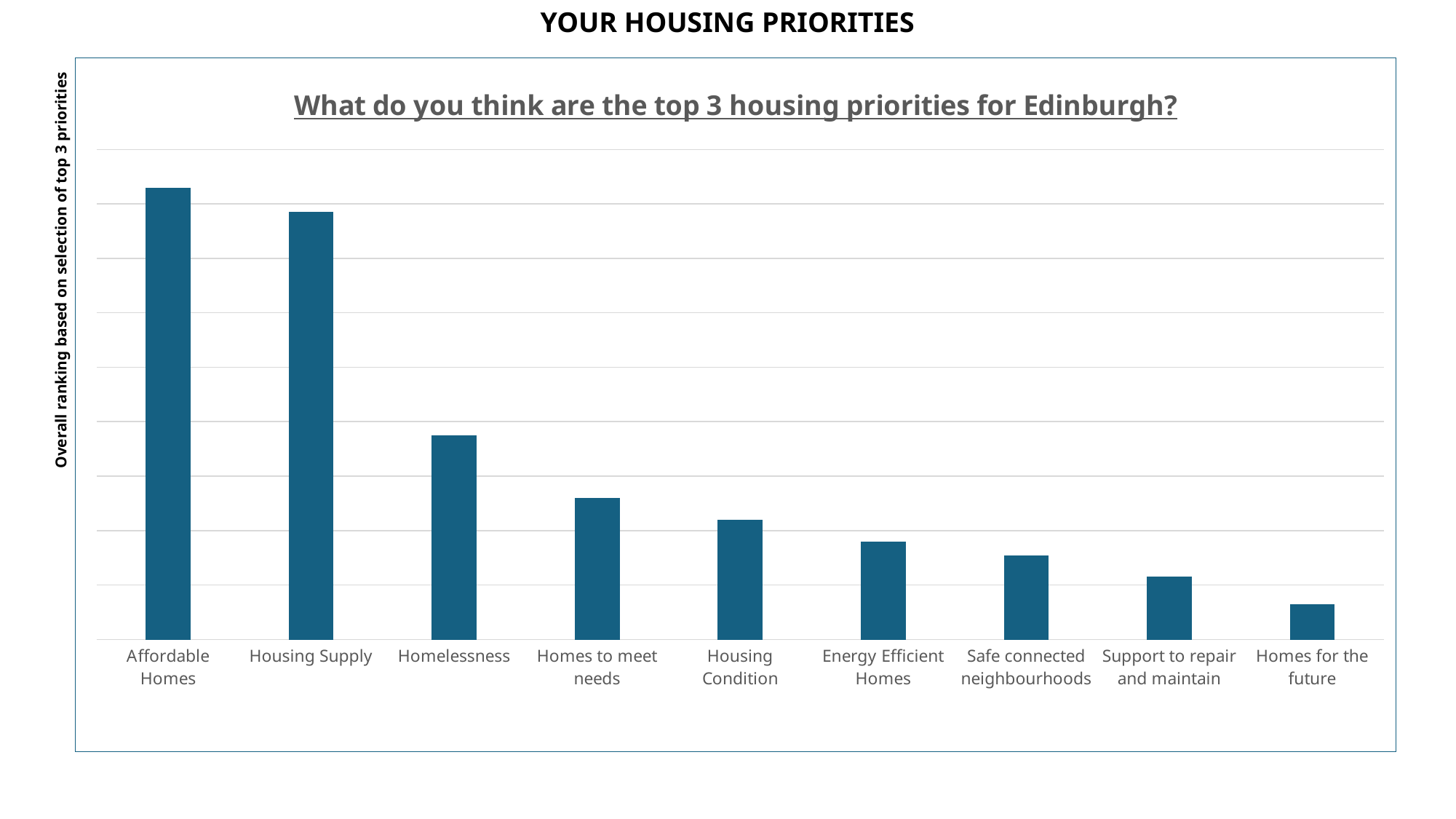
Which category has the highest value in the chart? Affordable Homes What is the title of the chart? What do you think are the top 3 housing priorities for Edinburgh? How many categories are shown on the x axis of the chart? 9 Which is larger, the value for Homelessness or the value for Homes to meet needs? Homelessness Do the values rise or fall moving from left to right along the x axis? Fall Which is larger, the value for Safe connected neighbourhoods or the value for Support to repair and maintain? Safe connected neighbourhoods Which is larger, the value for Housing Condition or the value for Energy Efficient Homes? Housing Condition What is the label on the vertical axis of the chart? Overall ranking based on selection of top 3 priorities What kind of chart is shown on the slide? Bar chart Which category has the lowest value in the chart? Homes for the future Which category is second from the left on the x axis? Housing Supply